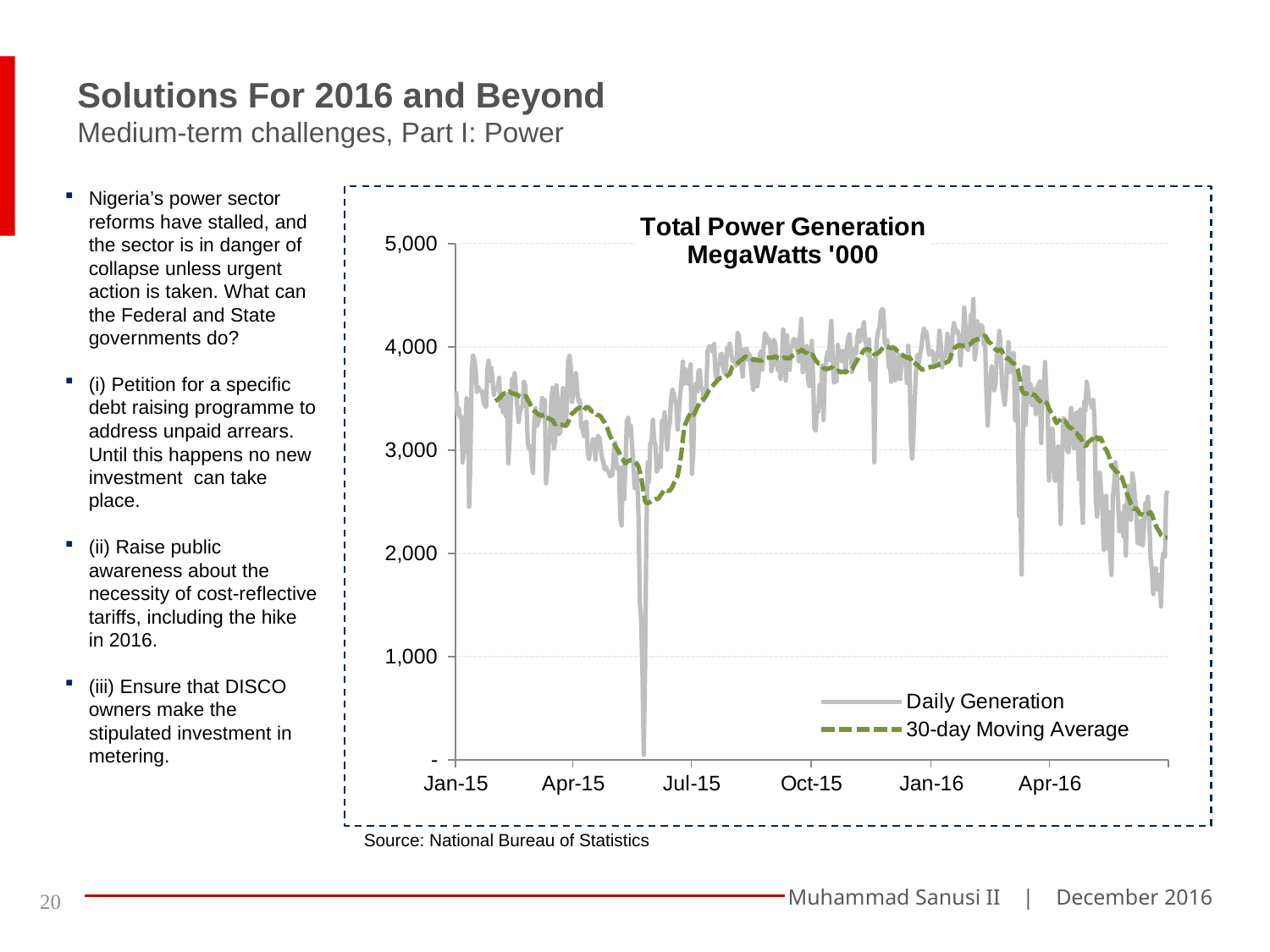
Is the 30-day Moving Average at the right-hand end of the series greater or less than 3,000? less Does the 30-day Moving Average rise or fall between Jan-16 and the end of the series? fall Is the 30-day Moving Average at Apr-15 greater or less than 3,000? greater Which series is drawn as a dashed line in the chart? 30-day Moving Average How many labelled tick marks are shown on the x axis? 6 Is the 30-day Moving Average at Jan-16 greater or less than 3,000? greater How many series does the chart's legend list? 2 What is the title of the chart? Total Power Generation MegaWatts '000 Does the 30-day Moving Average rise or fall between Jul-15 and Oct-15? rise What kind of chart is shown on the slide? line chart